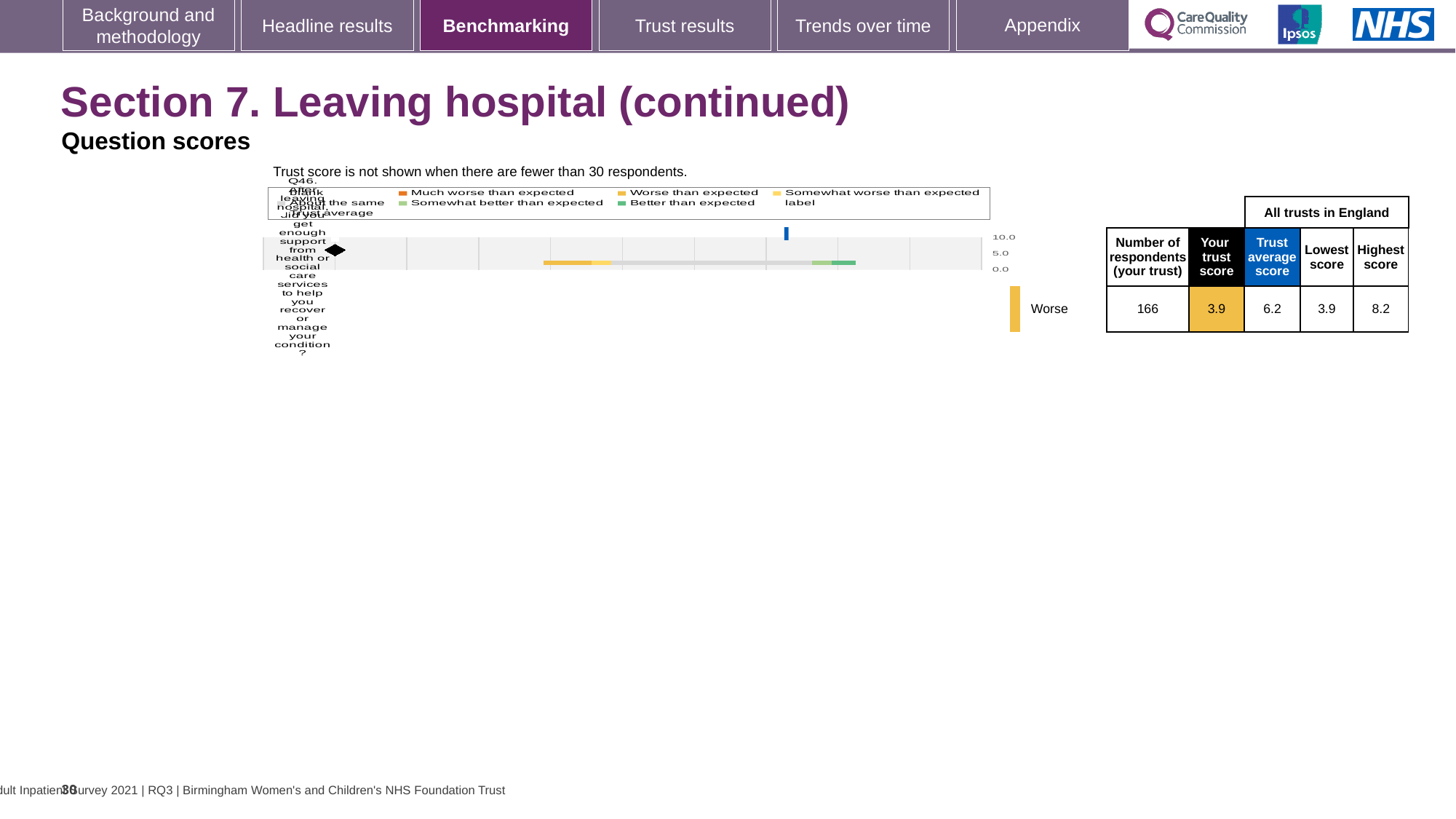
What is the trust average score for Q46 across all trusts in England? 6.2 What benchmark category label is shown next to the chart for Q46? Worse What is the lowest score among all trusts in England for Q46? 3.9 What is the difference between the trust average score and this trust's score for Q46? 2.3 Which is larger for Q46: the trust's own score or the trust average score? Trust average score How many questions are plotted on the chart? 1 What is the highest score among all trusts in England for Q46? 8.2 Is the trust score for Q46 greater or less than 5.0 on the chart axis? less What is the difference between the highest and lowest scores for Q46 across all trusts in England? 4.3 How many respondents from the trust answered Q46? 166 What is the maximum value shown on the chart's score axis? 10.0 What is the trust score for Q46 shown on the slide? 3.9